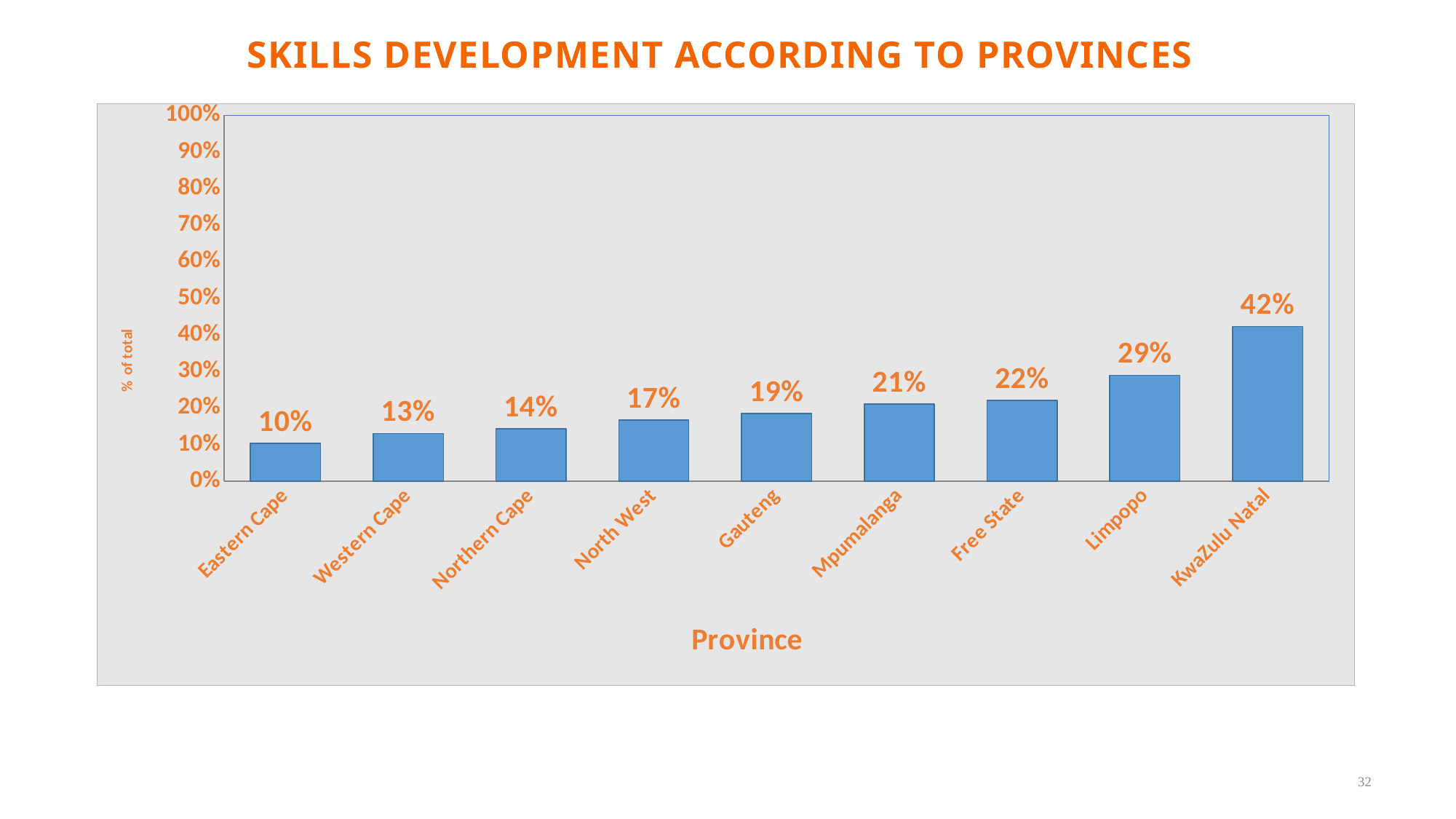
What is the value for Eastern Cape? 10% Is the value for Mpumalanga greater or less than 30%? less How many provinces are shown on the chart? 9 Which province has the lowest value? Eastern Cape What kind of chart is shown on the slide? bar chart Which province has the highest value? KwaZulu Natal What is the difference between the values for KwaZulu Natal and Limpopo? 13% What is the value for Limpopo? 29% What is the title of the chart? SKILLS DEVELOPMENT ACCORDING TO PROVINCES Which is larger, the value for Free State or the value for North West? Free State What is the value for Gauteng? 19% Do the values rise or fall from Eastern Cape to KwaZulu Natal along the x axis? rise